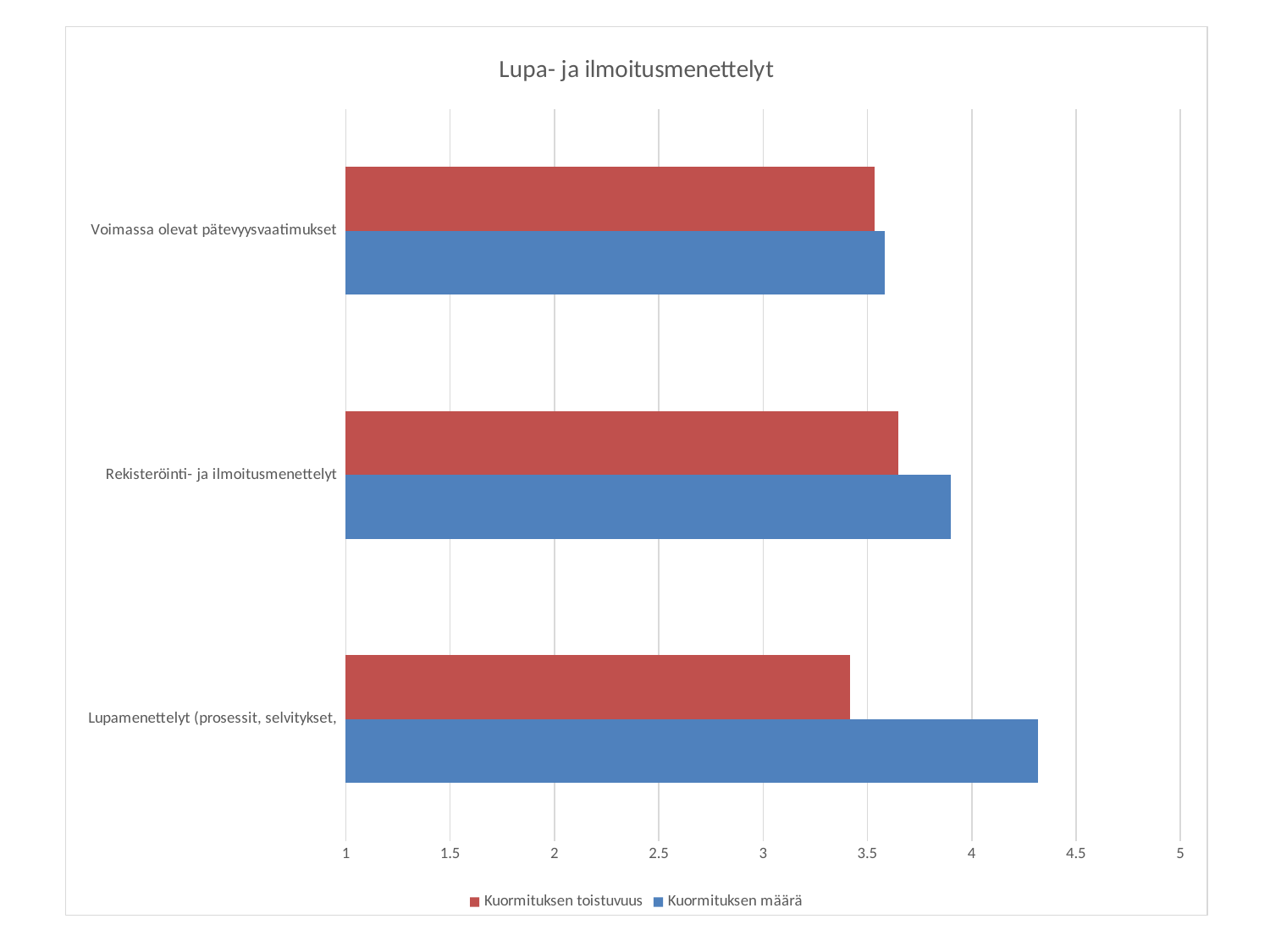
For Rekisteröinti- ja ilmoitusmenettelyt, which series has the larger value, Kuormituksen toistuvuus or Kuormituksen määrä? Kuormituksen määrä How many series does the legend list? 2 Which series is shown in blue? Kuormituksen määrä Which category has the highest value for Kuormituksen määrä? Lupamenettelyt (prosessit, selvitykset, Is the Kuormituksen toistuvuus value for Rekisteröinti- ja ilmoitusmenettelyt greater or less than 3.5? greater Which category has the lowest value for Kuormituksen määrä? Voimassa olevat pätevyysvaatimukset How many categories are shown on the chart? 3 What is the title of the chart? Lupa- ja ilmoitusmenettelyt For Lupamenettelyt (prosessit, selvitykset, which series has the larger value, Kuormituksen toistuvuus or Kuormituksen määrä? Kuormituksen määrä Is the Kuormituksen toistuvuus value for Lupamenettelyt (prosessit, selvitykset, greater or less than 3.5? less Is the Kuormituksen määrä value for Lupamenettelyt (prosessit, selvitykset, greater or less than 4? greater What kind of chart is shown on the slide? bar chart